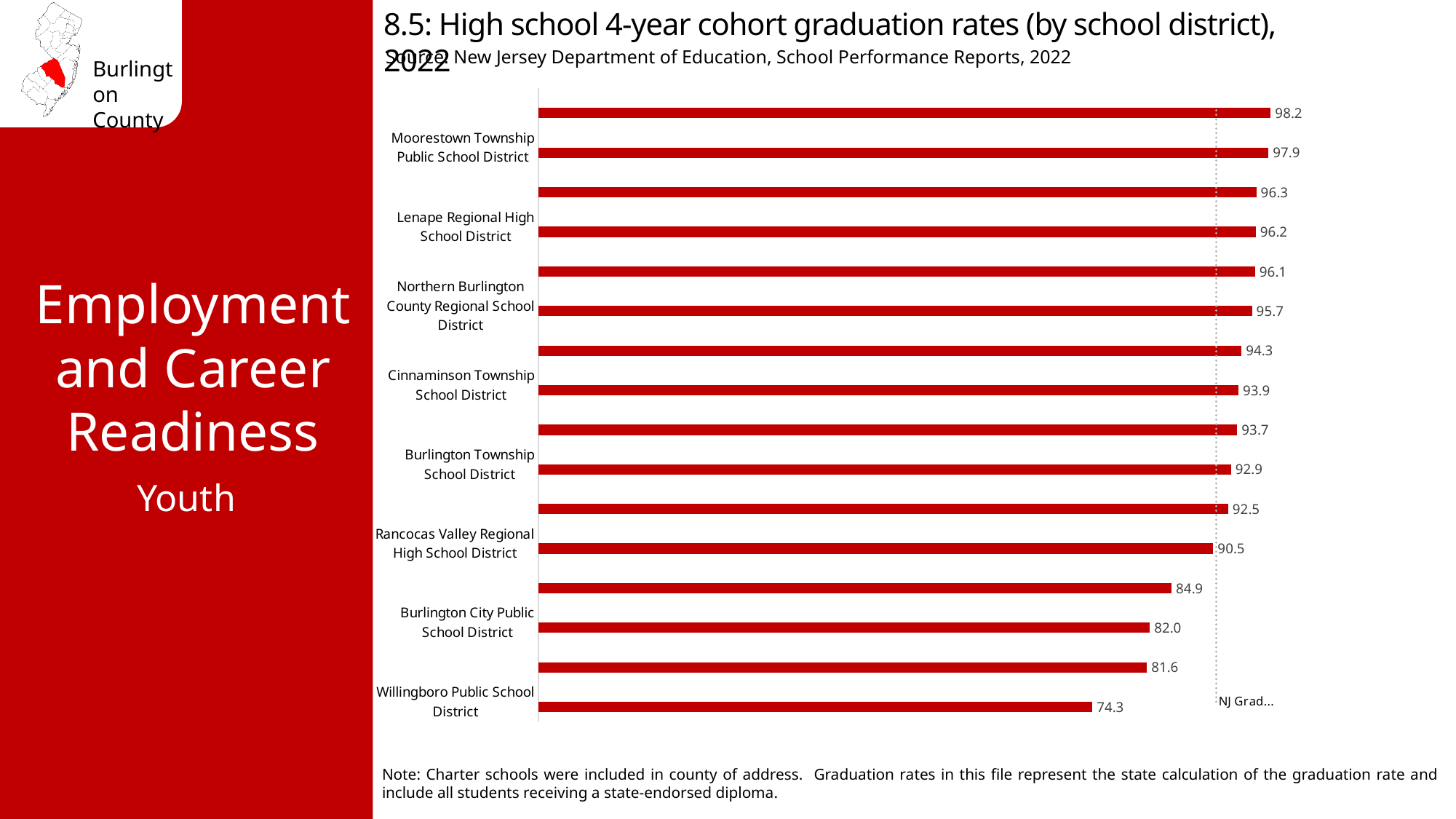
What type of chart is shown on the slide? Bar chart Do the graduation rates increase or decrease going from the top bar to the bottom bar? Decrease What is the graduation rate for Burlington City Public School District? 82.0 What is the highest graduation rate value shown on the chart? 98.2 What is the graduation rate for Lenape Regional High School District? 96.2 What is the graduation rate for Rancocas Valley Regional High School District? 90.5 What is the difference between the graduation rates of Moorestown Township Public School District and Willingboro Public School District? 23.6 What is the graduation rate for Moorestown Township Public School District? 97.9 Which labeled school district has the lowest graduation rate? Willingboro Public School District Which has a higher graduation rate, Northern Burlington County Regional School District or Cinnaminson Township School District? Northern Burlington County Regional School District What is the graduation rate for Willingboro Public School District? 74.3 How many bars are plotted on the chart? 16